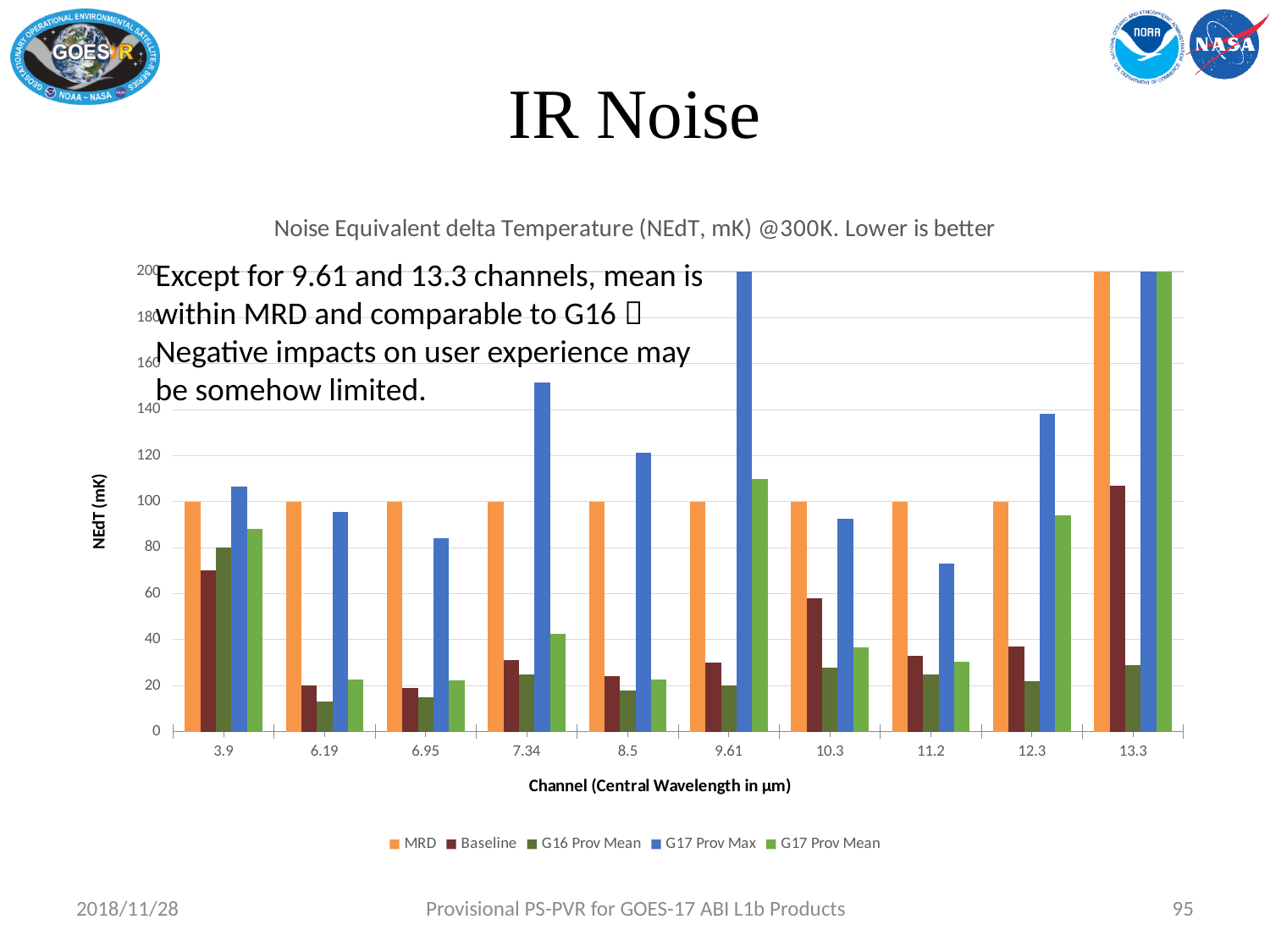
Is the G17 Prov Mean value for the 9.61 channel greater or less than 100? greater Is the G17 Prov Max value for the 11.2 channel greater or less than 60? greater Is the Baseline value for the 3.9 channel greater or less than 60? greater What kind of chart is shown on the slide? bar chart How many series does the legend list? 5 What is the label of the x axis? Channel (Central Wavelength in μm) Which channel has the larger G17 Prov Max value, 7.34 or 8.5? 7.34 What is the title of the chart? Noise Equivalent delta Temperature (NEdT, mK) @300K. Lower is better How many channels are shown along the x axis? 10 Which channel has the highest G17 Prov Mean value? 13.3